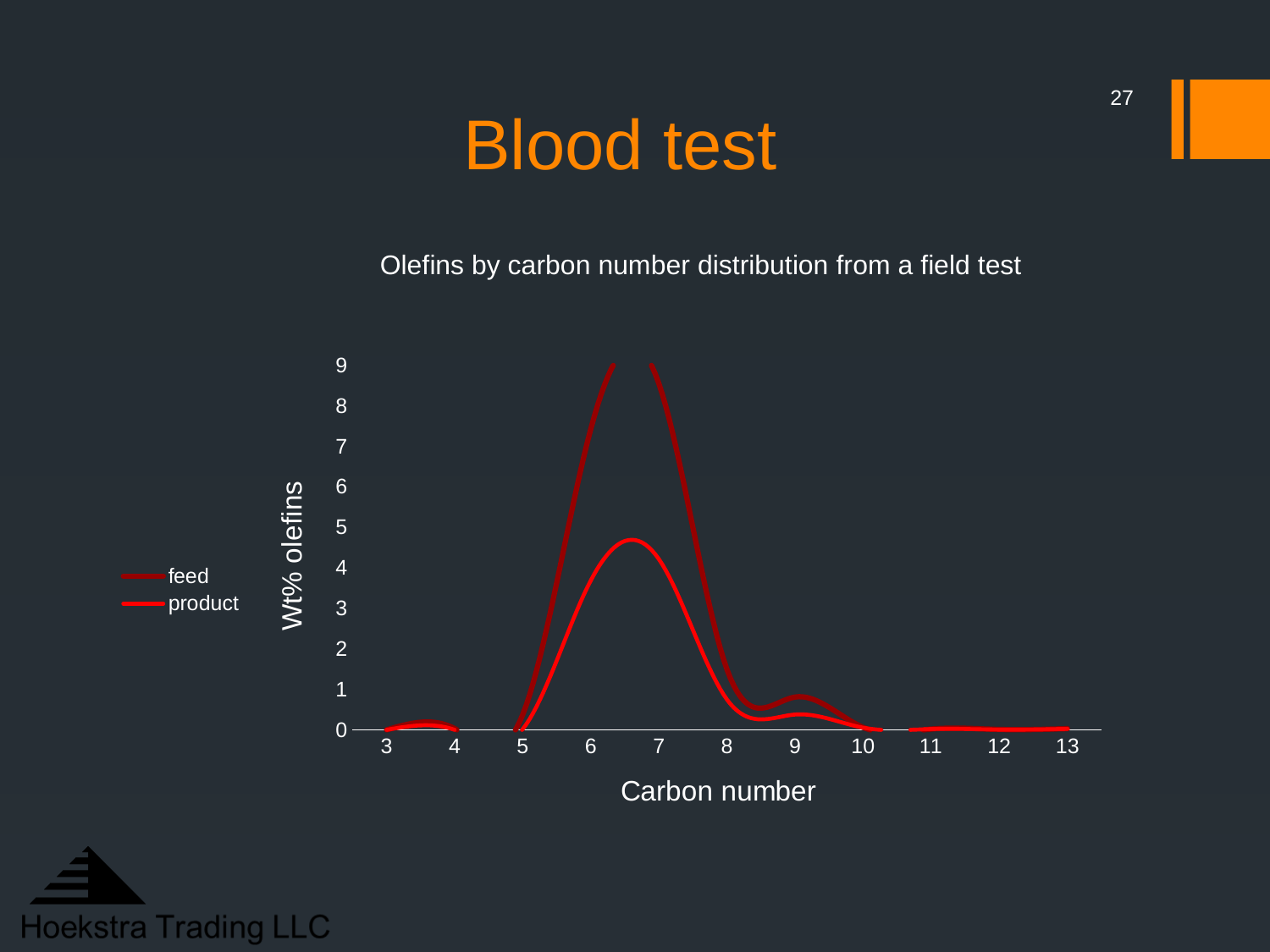
Do the values of the feed series rise or fall between carbon number 7 and carbon number 8? fall Is the peak value of the product series greater or less than 4? greater What kind of chart is shown on the slide? line chart How many carbon number ticks are shown on the x axis? 11 Is the peak value of the product series greater or less than 5? less At which carbon number range do both series reach their highest values? between 6 and 7 How many series does the legend list? 2 Which series reaches the higher peak, feed or product? feed Is the value of the feed series at carbon number 9 greater or less than 1? less What are the two series named in the legend? feed and product What is the title of the chart? Olefins by carbon number distribution from a field test